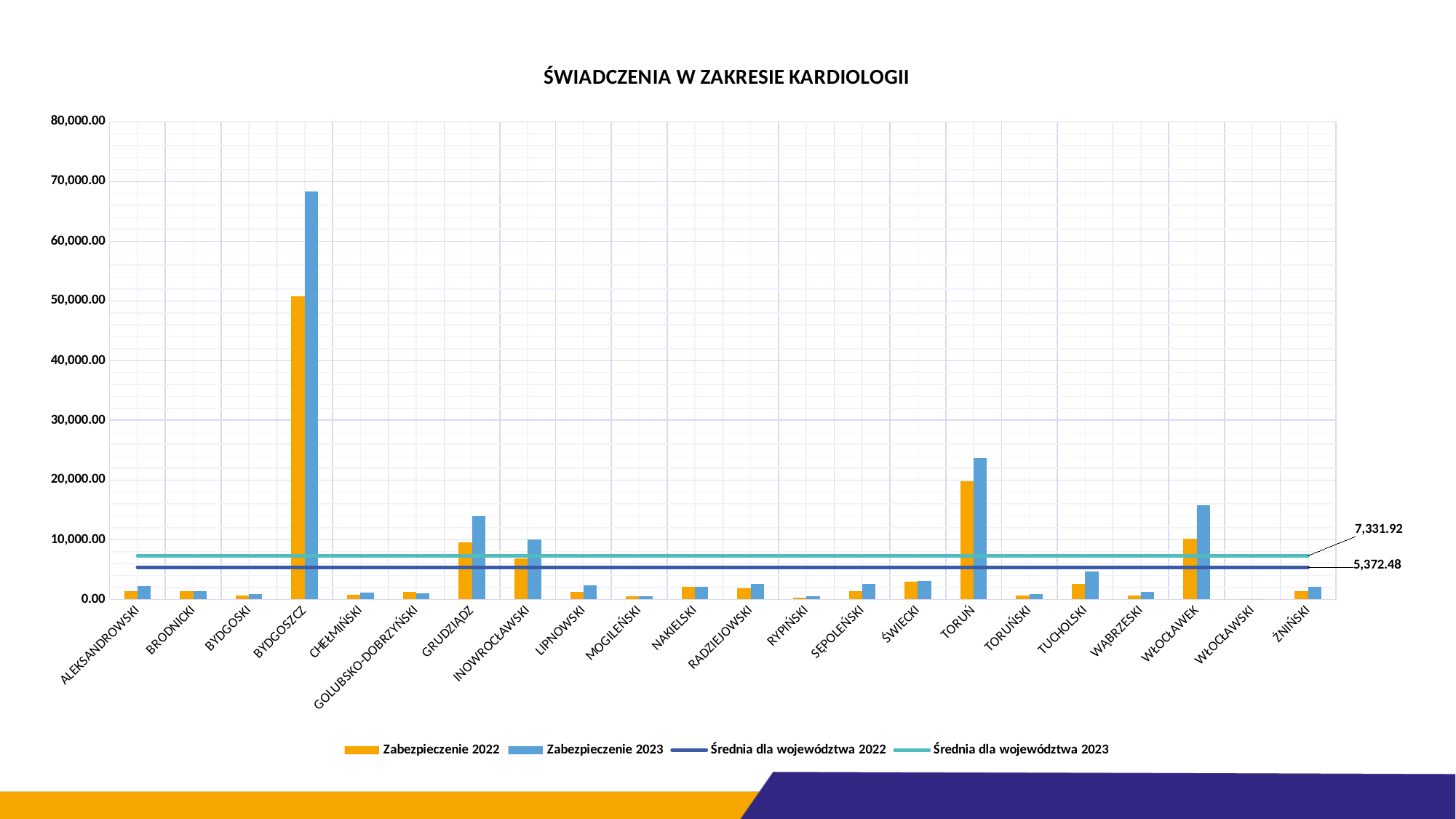
What is the difference between the Średnia dla województwa 2023 and Średnia dla województwa 2022 values? 1,959.44 How many entries does the legend list? 4 What is the value of the Średnia dla województwa 2023 line? 7,331.92 How many categories are shown on the x axis? 22 What kind of chart is shown on the slide? combination bar and line chart Is the Zabezpieczenie 2023 value for TORUŃ greater or less than 20,000.00? greater What is the title of the chart? ŚWIADCZENIA W ZAKRESIE KARDIOLOGII Is the Zabezpieczenie 2023 value for BYDGOSZCZ greater or less than 60,000.00? greater What is the value of the Średnia dla województwa 2022 line? 5,372.48 Which category has the highest Zabezpieczenie 2023 value? BYDGOSZCZ Which category has the highest Zabezpieczenie 2022 value? BYDGOSZCZ Which is larger, the Zabezpieczenie 2023 value for TORUŃ or for WŁOCŁAWEK? TORUŃ